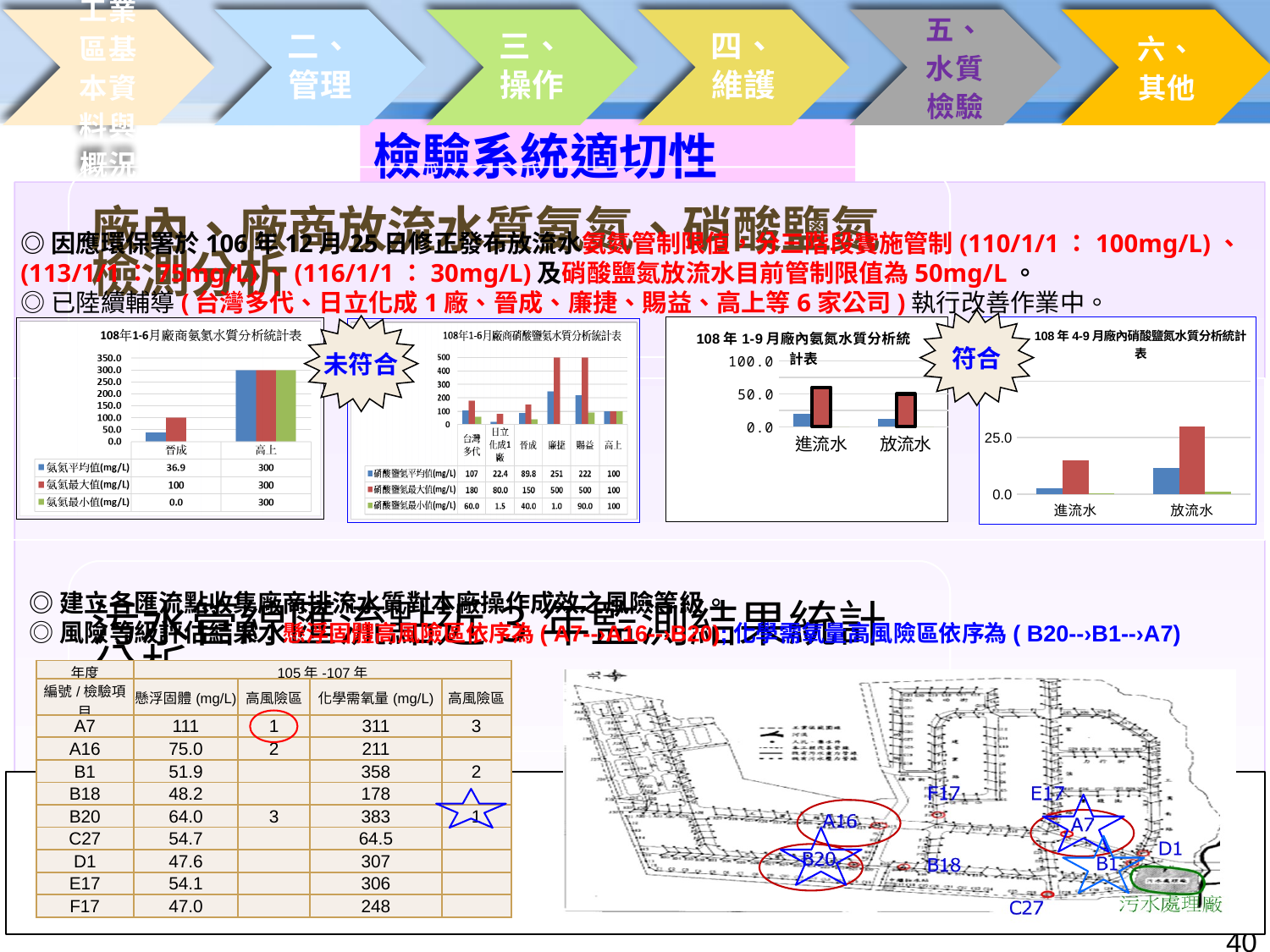
In the chart titled 108年1-6月廠商硝酸鹽氮水質分析統計表, which is larger: the 硝酸鹽氮平均值(mg/L) for 台灣多代 or for 晉成? 台灣多代 In the chart titled 108年1-6月廠商硝酸鹽氮水質分析統計表, how many companies are shown on the x axis? 6 In the chart titled 108年4-9月廠內硝酸鹽氮水質分析統計表, is the value of the red bar for 放流水 greater or less than 25.0? greater In the chart titled 108年1-6月廠商氨氮水質分析統計表, how many series does the legend list? 3 In the chart titled 108年1-6月廠商硝酸鹽氮水質分析統計表, what is the difference between the 硝酸鹽氮最大值(mg/L) and 硝酸鹽氮最小值(mg/L) for 賜益? 410 What kind of chart is the one titled 108年1-9月廠內氨氮水質分析統計表? bar chart In the chart titled 108年1-6月廠商硝酸鹽氮水質分析統計表, what is the 硝酸鹽氮平均值(mg/L) for 廉捷? 251 In the chart titled 108年1-6月廠商硝酸鹽氮水質分析統計表, what is the 硝酸鹽氮最小值(mg/L) for 日立化成1廠? 1.5 In the chart titled 108年1-6月廠商氨氮水質分析統計表, what is the 氨氮最大值(mg/L) for 高上? 300 In the chart titled 108年1-6月廠商硝酸鹽氮水質分析統計表, which company has the highest 硝酸鹽氮平均值(mg/L)? 廉捷 In the chart titled 108年1-6月廠商硝酸鹽氮水質分析統計表, which company has the lowest 硝酸鹽氮最小值(mg/L)? 廉捷 In the chart titled 108年1-6月廠商氨氮水質分析統計表, what is the 氨氮平均值(mg/L) for 晉成? 36.9